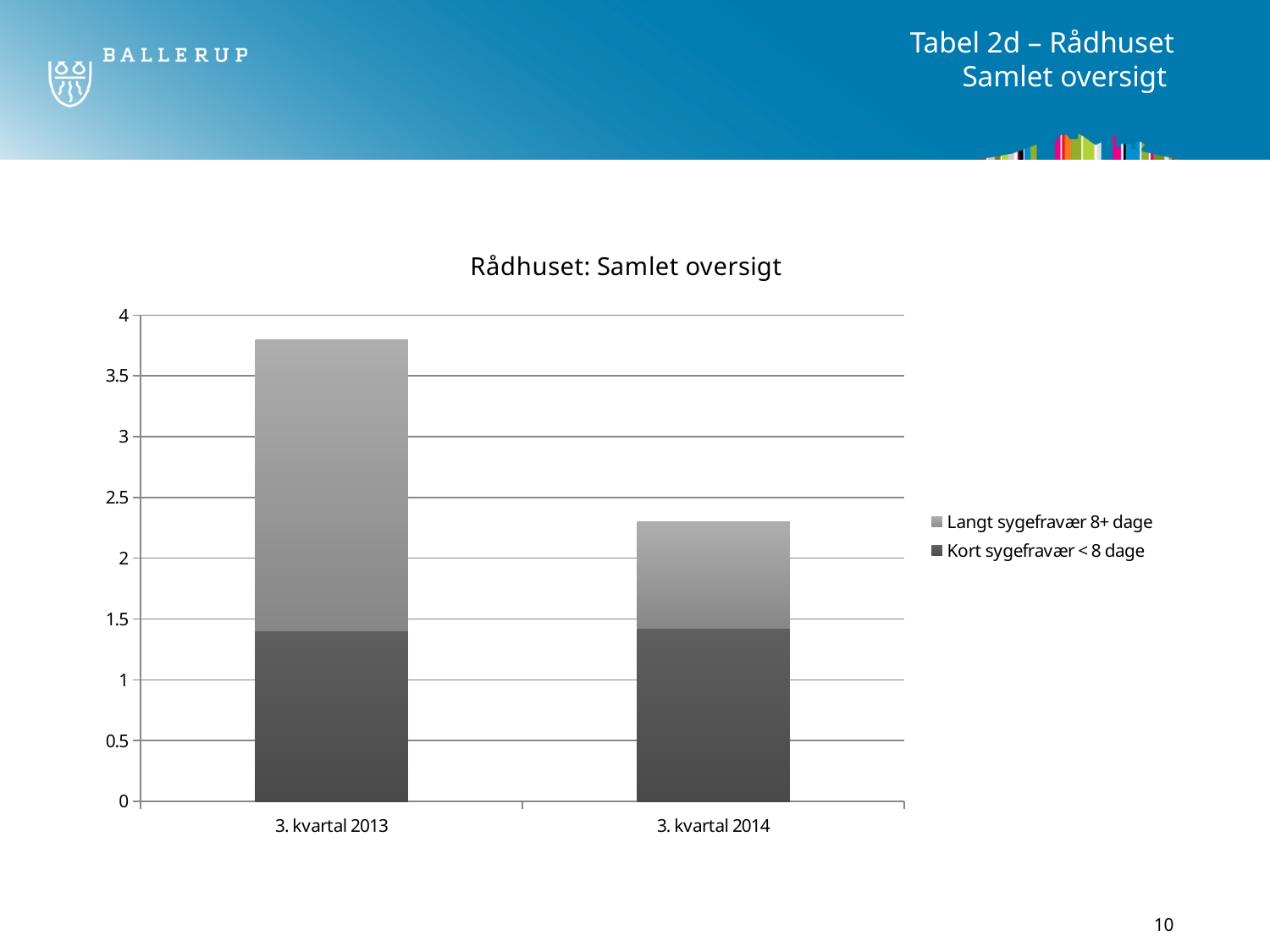
Is the Langt sygefravær 8+ dage segment for 3. kvartal 2013 greater or less than 2? greater What type of chart is shown on the slide? Stacked bar chart Is the total bar for 3. kvartal 2013 greater or less than 3.5? greater Does the total bar height rise or fall from 3. kvartal 2013 to 3. kvartal 2014? fall What is the title of the chart? Rådhuset: Samlet oversigt Is the total bar for 3. kvartal 2014 greater or less than 2.5? less Which category has the lowest total bar? 3. kvartal 2014 Which category has the highest total bar? 3. kvartal 2013 Which legend entry is shown in the lighter grey colour? Langt sygefravær 8+ dage How many series does the legend list? 2 How many categories are shown on the x axis? 2